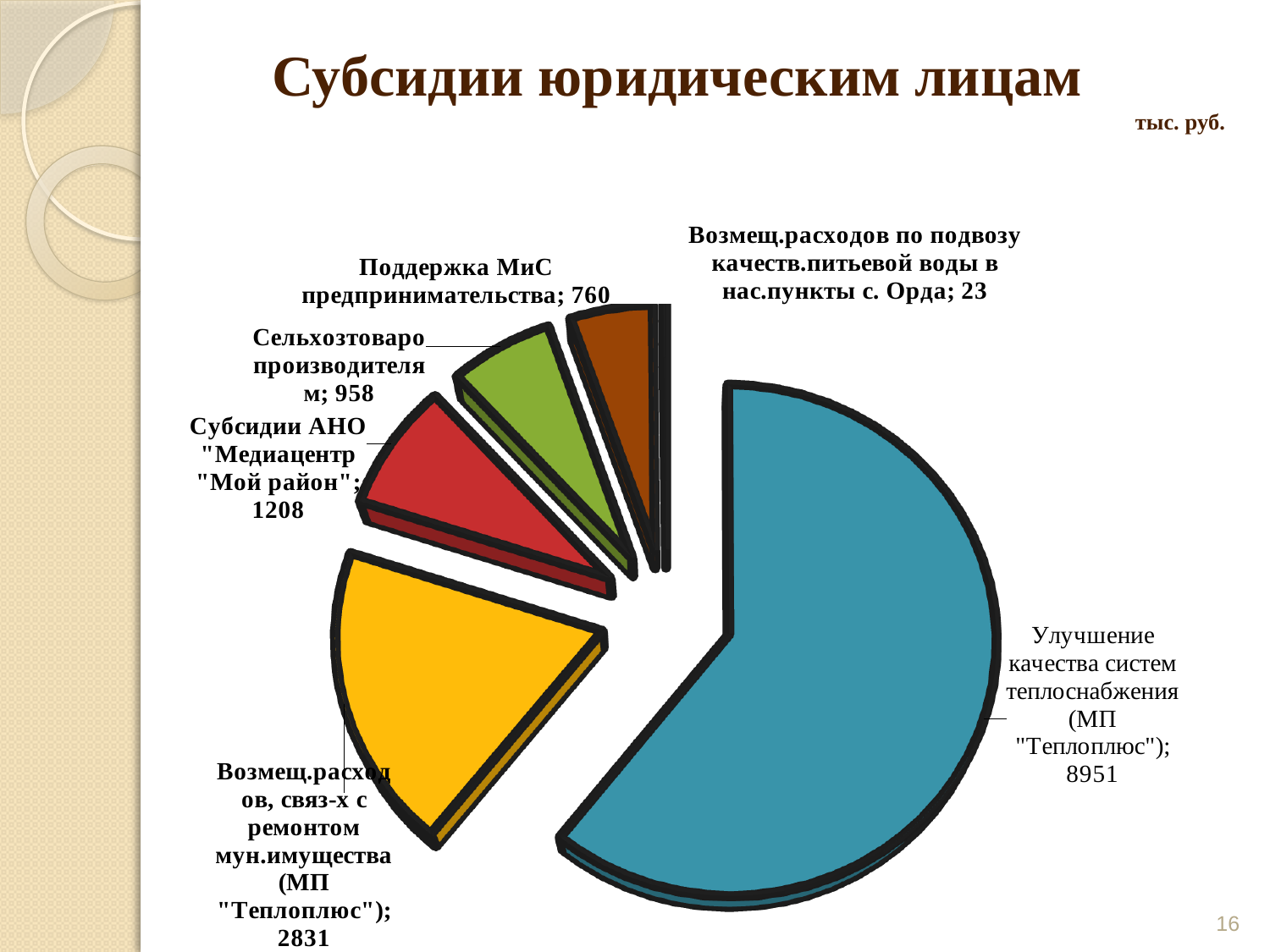
Which is larger: the value for Сельхозтоваропроизводителям or the value for Поддержка МиС предпринимательства? Сельхозтоваропроизводителям Which category has the smallest slice of the pie? Возмещ.расходов по подвозу качеств.питьевой воды в нас.пункты с. Орда How many slices does the pie chart have? 6 Which category has the largest slice of the pie? Улучшение качества систем теплоснабжения (МП "Теплоплюс") What is the value for Сельхозтоваропроизводителям? 958 What is the value for Поддержка МиС предпринимательства? 760 What is the value for Возмещ.расходов, связ-х с ремонтом мун.имущества (МП "Теплоплюс")? 2831 What is the difference between the value for Улучшение качества систем теплоснабжения (МП "Теплоплюс") and the value for Возмещ.расходов, связ-х с ремонтом мун.имущества (МП "Теплоплюс")? 6120 What is the value for Субсидии АНО "Медиацентр "Мой район"? 1208 What is the value for Улучшение качества систем теплоснабжения (МП "Теплоплюс")? 8951 What unit is stated for the values in the chart? тыс. руб. What kind of chart is shown on the slide? pie chart